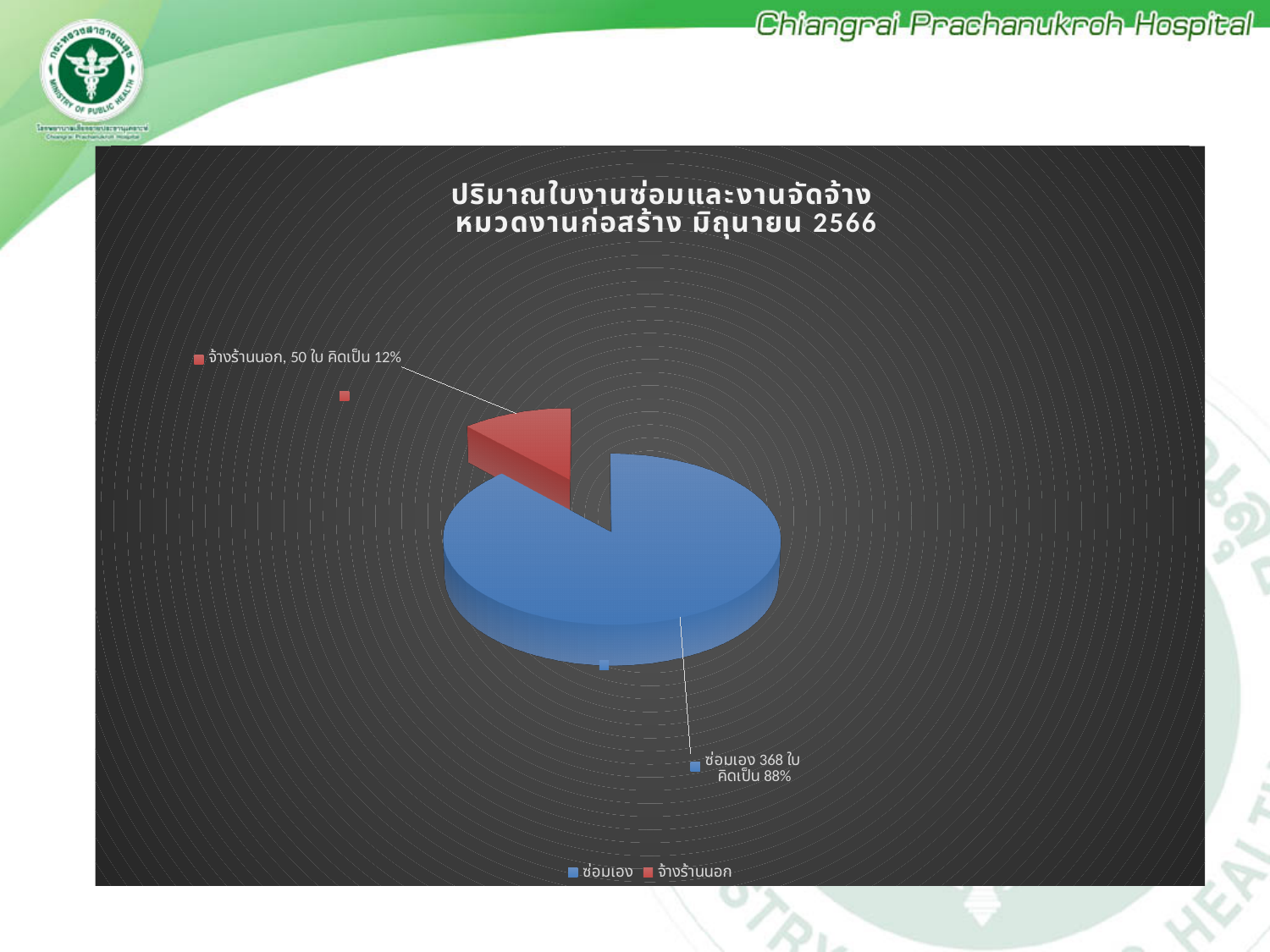
Which category has the largest slice? ซ่อมเอง What share of the pie does จ้างร้านนอก represent? 12% How many entries does the legend list? 2 What kind of chart is shown on the slide? pie chart How many ใบ are shown for จ้างร้านนอก? 50 ใบ How many slices does the pie chart have? 2 Which category has the smallest slice? จ้างร้านนอก Which colour represents จ้างร้านนอก in the chart? red How many ใบ are shown for ซ่อมเอง? 368 ใบ What is the total number of ใบ across both categories? 418 ใบ What is the difference in ใบ between ซ่อมเอง and จ้างร้านนอก? 318 ใบ What share of the pie does ซ่อมเอง represent? 88%